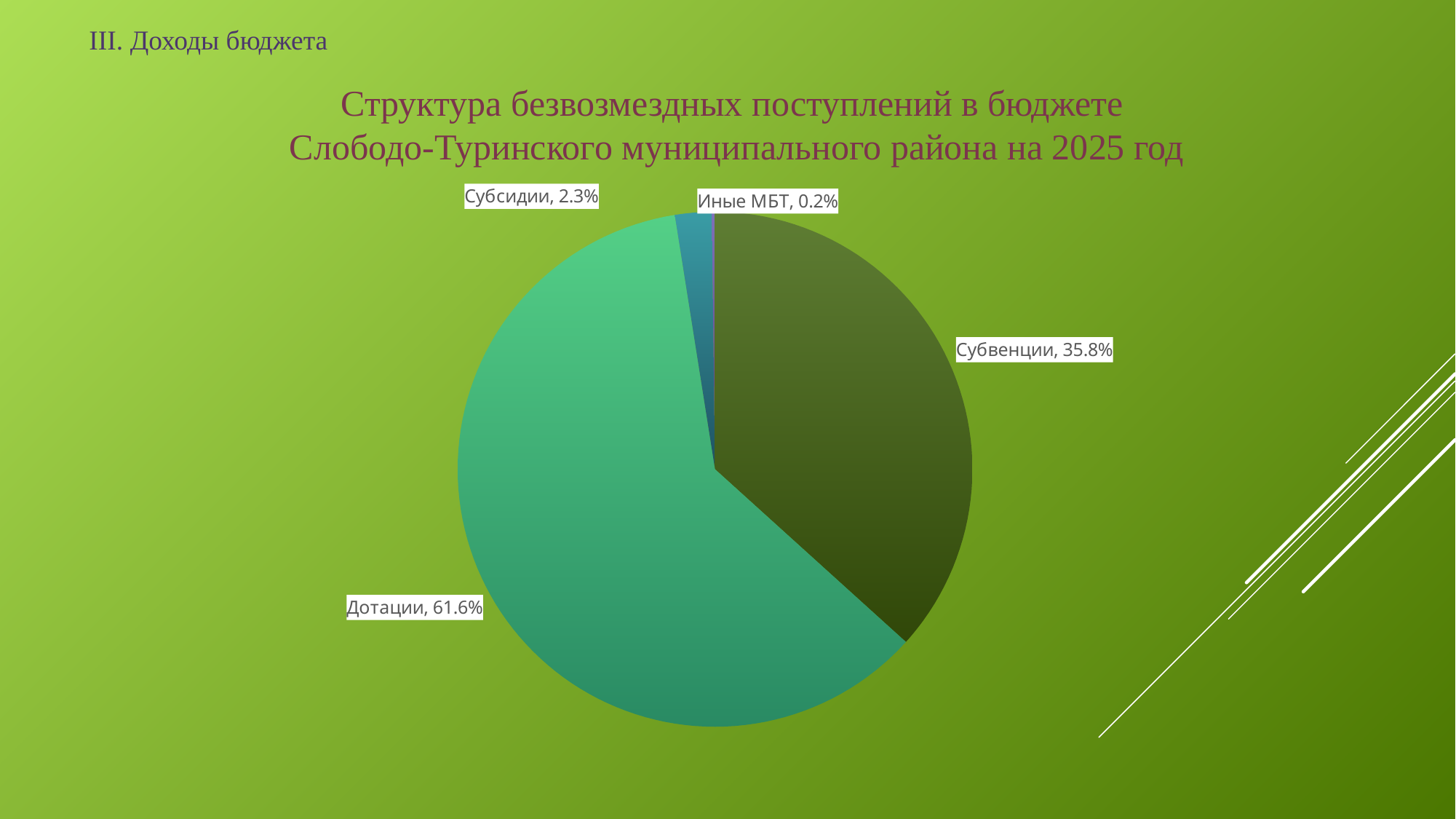
What is the title of the chart? Структура безвозмездных поступлений в бюджете Слободо-Туринского муниципального района на 2025 год What is the value shown for Иные МБТ? 0.2% What is the value shown for Субвенции? 35.8% What is the combined share of Субсидии and Иные МБТ? 2.5% What is the difference between the shares of Дотации and Субвенции? 25.8% Which is larger, the share of Субсидии or the share of Иные МБТ? Субсидии What is the value shown for Субсидии? 2.3% Which category has the largest slice of the pie? Дотации What kind of chart is shown on the slide? Pie chart What share of the pie does Дотации have? 61.6% How many categories are shown in the pie chart? 4 Which category has the smallest slice of the pie? Иные МБТ